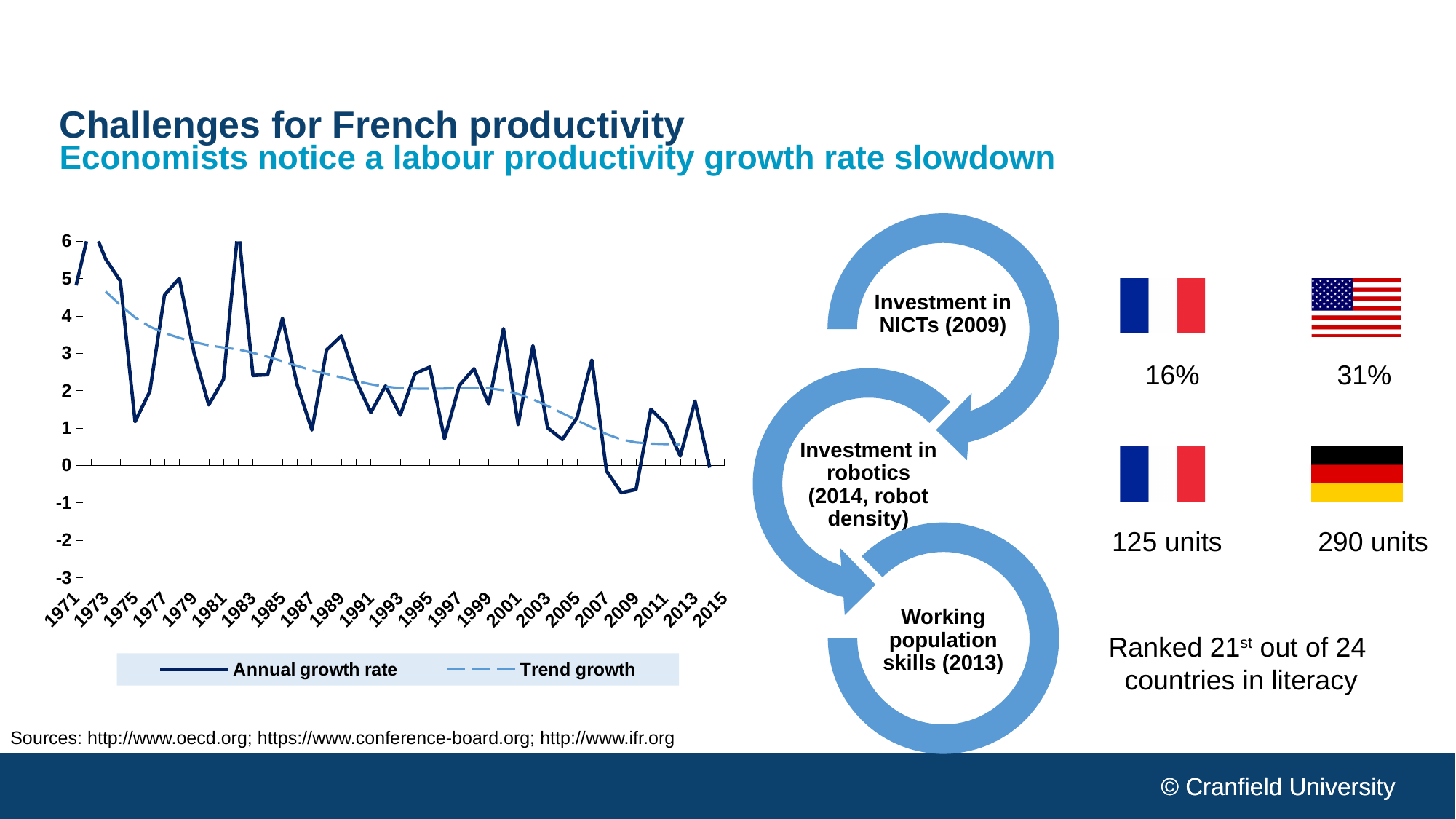
Which series in the chart is drawn with a dashed line? Trend growth How many year labels are shown on the x axis of the chart? 23 Is the Annual growth rate for 2001 greater or less than 3? less How many series does the legend of the chart list? 2 Is the Trend growth value for 2011 greater or less than 1? less Does the Trend growth line rise or fall from 1973 to 2013? fall Is the Annual growth rate for 2009 greater or less than 0? less What kind of chart is shown on the left of the slide? line chart What is the lowest value shown on the y axis of the chart? -3 What are the two series named in the chart legend? Annual growth rate and Trend growth Which year has the larger Annual growth rate, 1983 or 2009? 1983